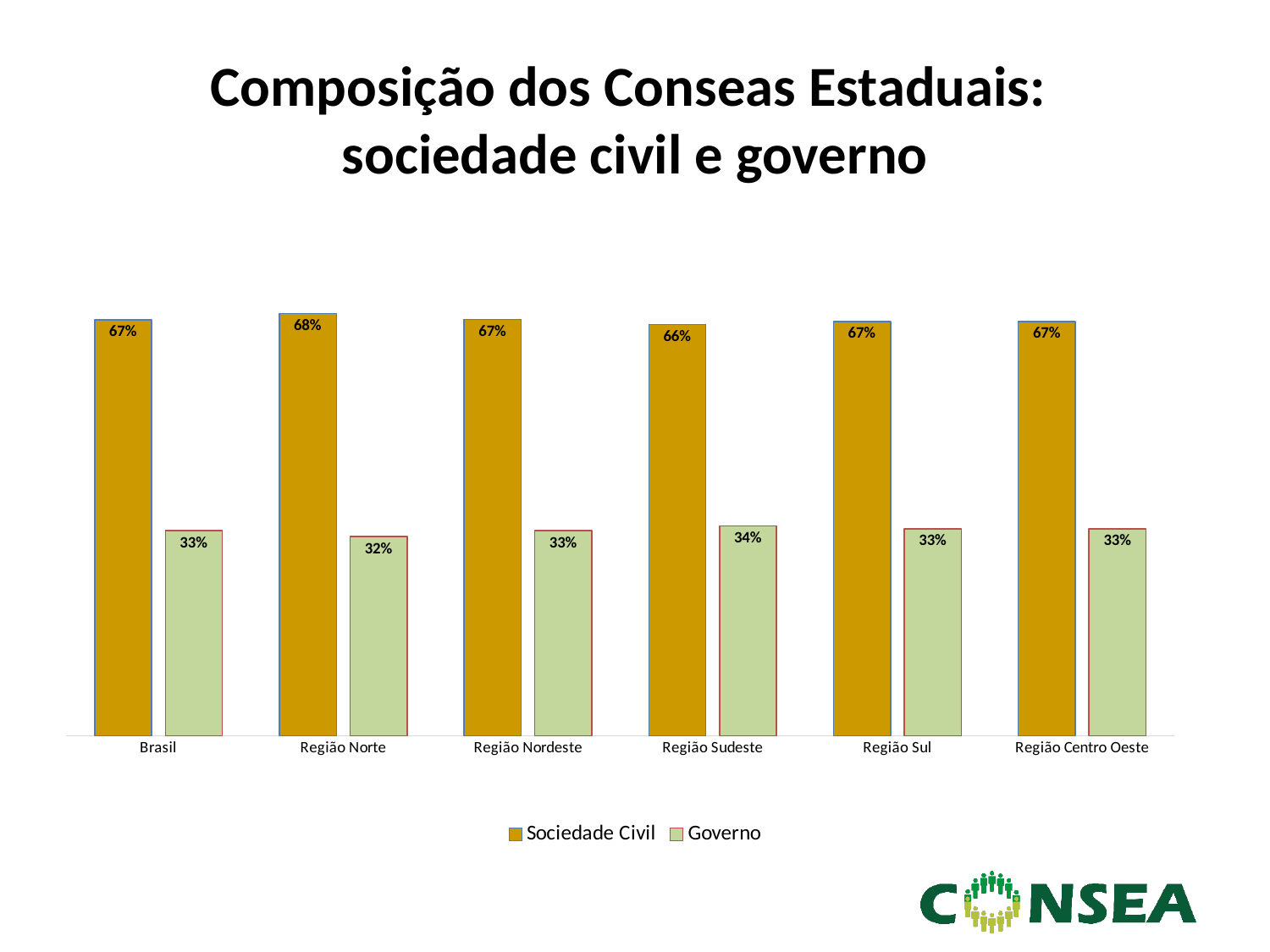
What is the Sociedade Civil value for Região Sudeste? 66% What is the Sociedade Civil value for Região Norte? 68% Which category has the lowest Governo value? Região Norte What is the difference between the Sociedade Civil and Governo values for Região Norte? 36% What is the Governo value for Região Sudeste? 34% What kind of chart is shown on the slide? Bar chart How many series does the legend list? 2 Which category has the highest Sociedade Civil value? Região Norte What is the title of the slide? Composição dos Conseas Estaduais: sociedade civil e governo How many categories are shown on the x axis? 6 Which is larger for Região Sul: Sociedade Civil or Governo? Sociedade Civil What is the Governo value for Brasil? 33%